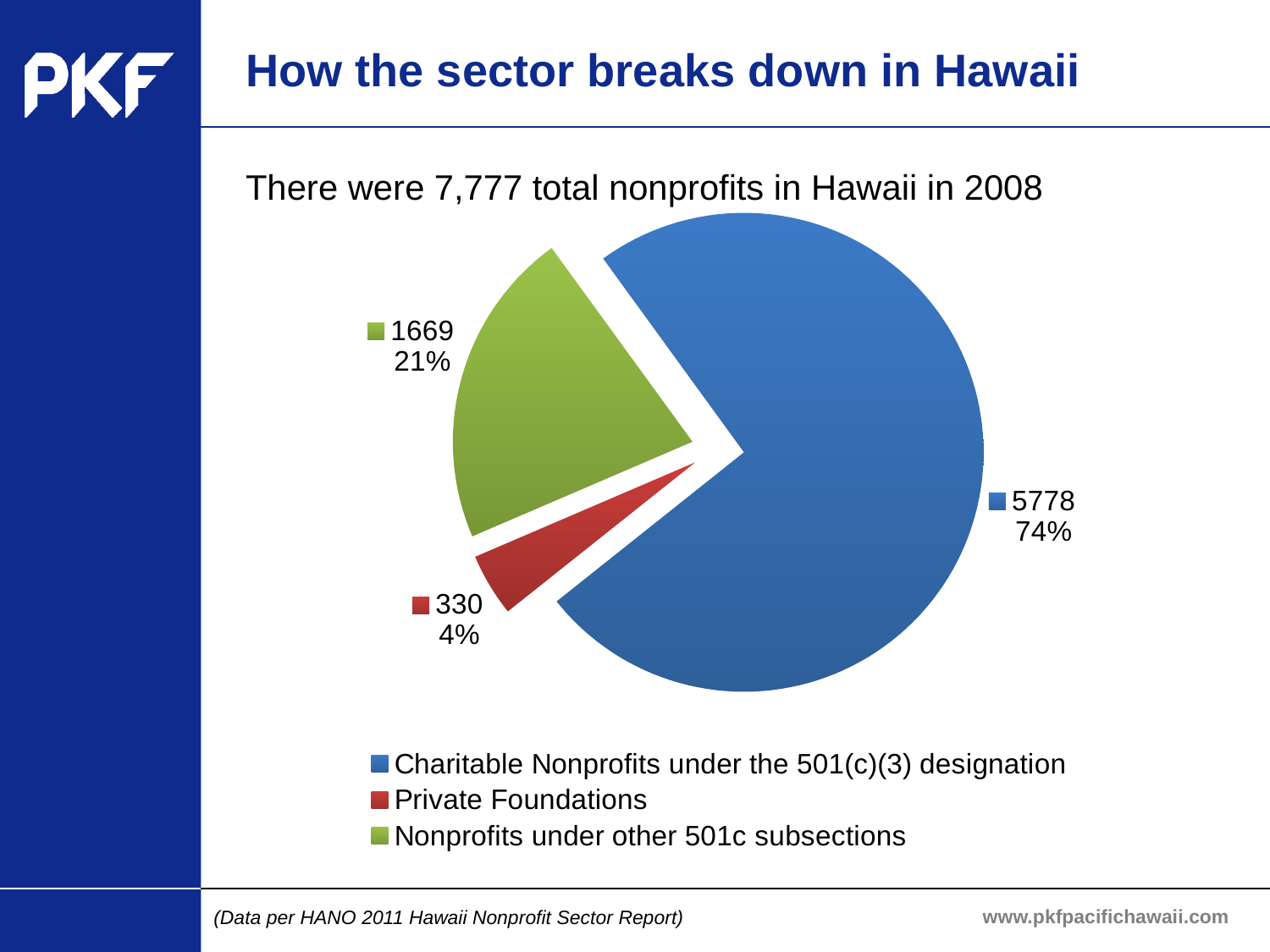
What share of the pie do Private Foundations represent? 4% What share of the pie do Nonprofits under other 501c subsections represent? 21% Which category has the smallest slice of the pie? Private Foundations How many categories does the pie chart show? 3 What share of the pie do Charitable Nonprofits under the 501(c)(3) designation represent? 74% How many Private Foundations are shown in the chart? 330 What kind of chart is shown on the slide? pie chart How many Nonprofits under other 501c subsections are shown? 1669 Which category has the largest slice of the pie? Charitable Nonprofits under the 501(c)(3) designation How many nonprofits are Charitable Nonprofits under the 501(c)(3) designation? 5778 What is the difference between the number of Nonprofits under other 501c subsections and the number of Private Foundations? 1339 What colour is the slice for Private Foundations? red